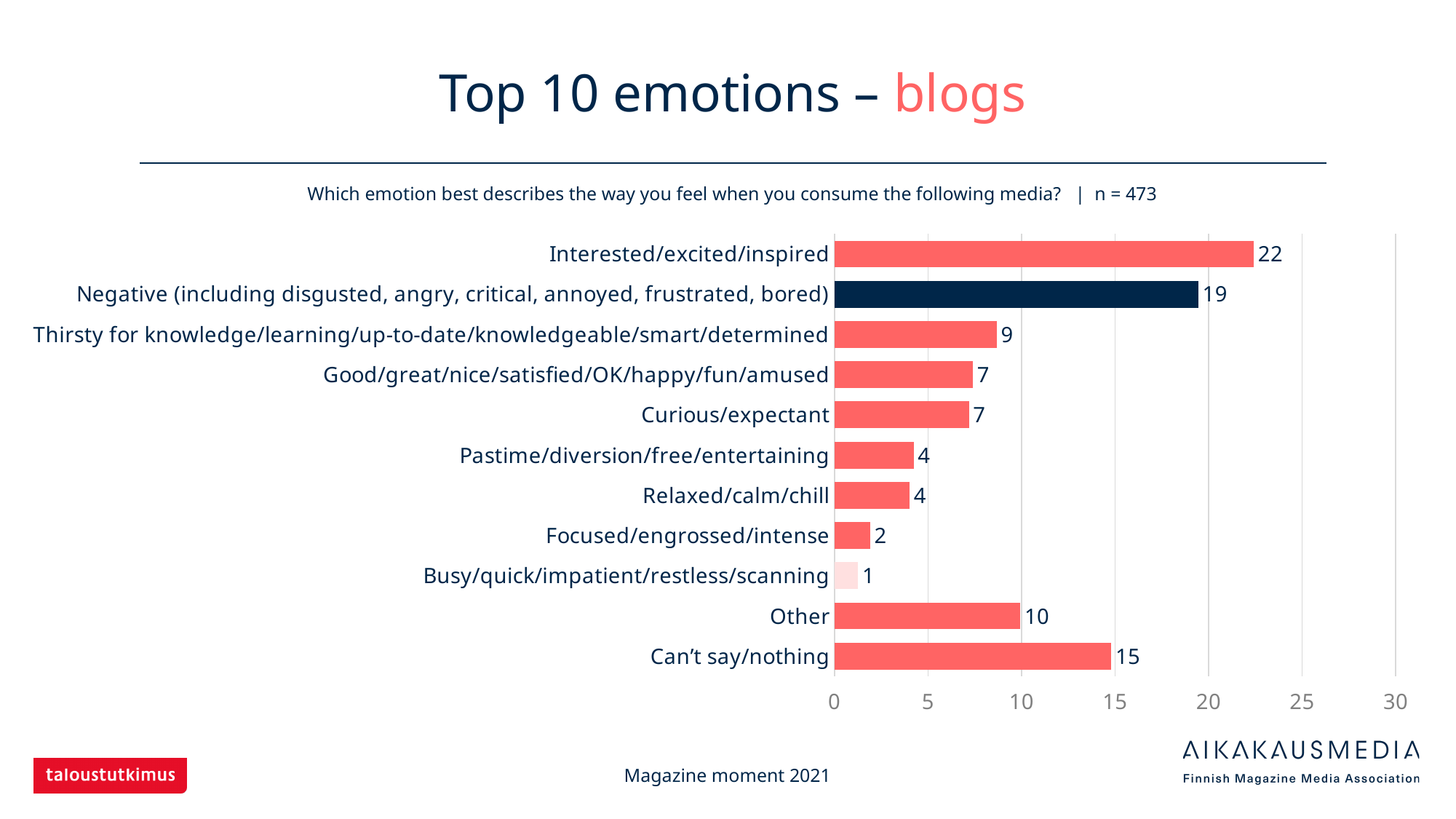
What kind of chart is shown on the slide? bar chart What is the value for Negative (including disgusted, angry, critical, annoyed, frustrated, bored)? 19 What is the sample size (n) stated on the slide? 473 What is the value for Can't say/nothing? 15 Is the value for Can't say/nothing greater or less than 20? less What is the value for Interested/excited/inspired? 22 How many categories are shown in the chart? 11 Which category has the highest value? Interested/excited/inspired What is the difference between the values for Interested/excited/inspired and Negative (including disgusted, angry, critical, annoyed, frustrated, bored)? 3 Which is larger, the value for Thirsty for knowledge/learning/up-to-date/knowledgeable/smart/determined or the value for Other? Other What is the value for Other? 10 Which category has the lowest value? Busy/quick/impatient/restless/scanning